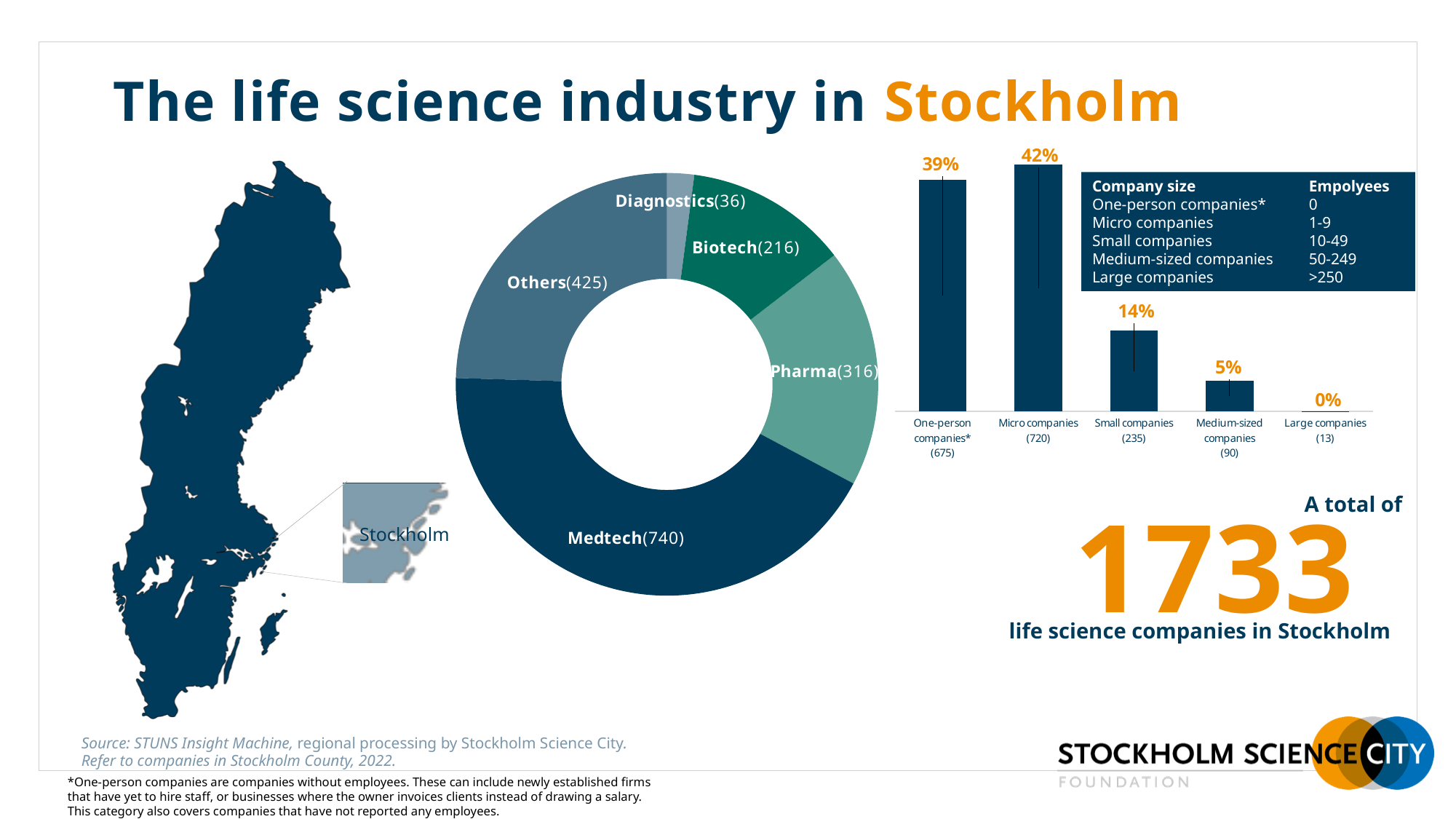
In the company size bar chart, which company size category has the highest percentage? Micro companies In the company size bar chart, what percentage is shown for Micro companies? 42% In the donut chart, which sector has the smallest number of companies? Diagnostics How many sectors are shown in the donut chart? 5 In the donut chart, what is the difference between the number of companies in Others and in Pharma? 109 In the donut chart, which sector has more companies, Biotech or Pharma? Pharma In the company size bar chart, which company size category has the lowest percentage? Large companies In the donut chart, how many companies are in the Medtech sector? 740 What kind of chart is used to show the sectors (Medtech, Pharma, Biotech, etc.)? Donut (pie) chart What kind of chart is used to show the company size distribution? Bar chart In the company size bar chart, what is the difference in percentage points between One-person companies and Small companies? 25 percentage points In the donut chart, which sector has the largest number of companies? Medtech